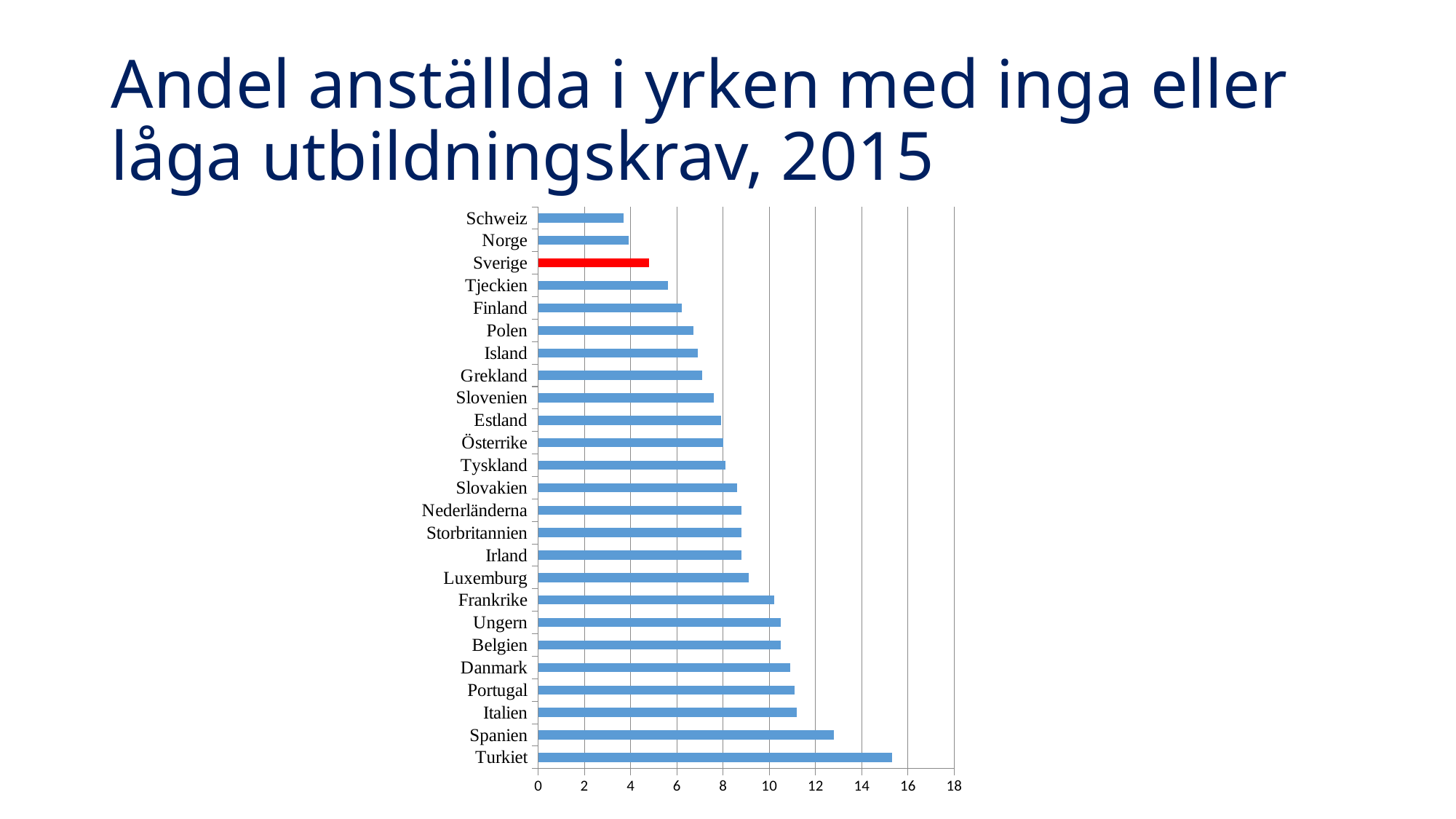
Is the value for Sverige greater or less than 6? less Is the value for Turkiet greater or less than 14? greater What kind of chart is shown on the slide? bar chart How many countries are shown in the chart? 25 Which country's bar is coloured red in the chart? Sverige Is the value for Schweiz greater or less than 4? less Which country has the highest value in the chart? Turkiet Which has the larger value, Sverige or Norge? Sverige Which has the larger value, Danmark or Finland? Danmark